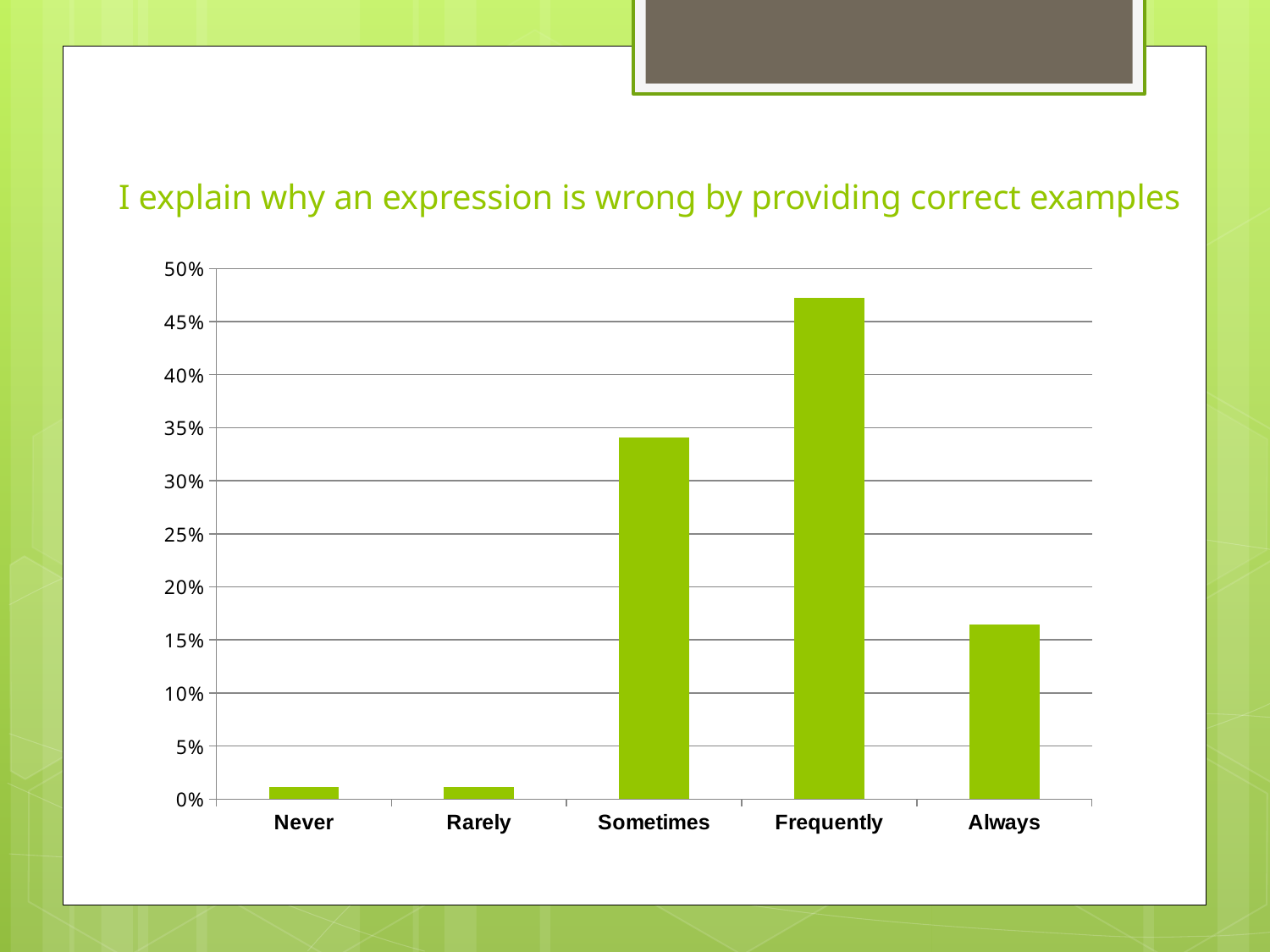
Is the value for Frequently greater or less than 45%? greater Is the value for Sometimes greater or less than 35%? less Is the value for Always greater or less than 15%? greater Which is larger, the value for Sometimes or the value for Always? Sometimes Which category has the highest value? Frequently What is the title of the chart? I explain why an expression is wrong by providing correct examples Which is larger, the value for Rarely or the value for Always? Always What kind of chart is shown on the slide? bar chart How many categories are shown on the x axis of the chart? 5